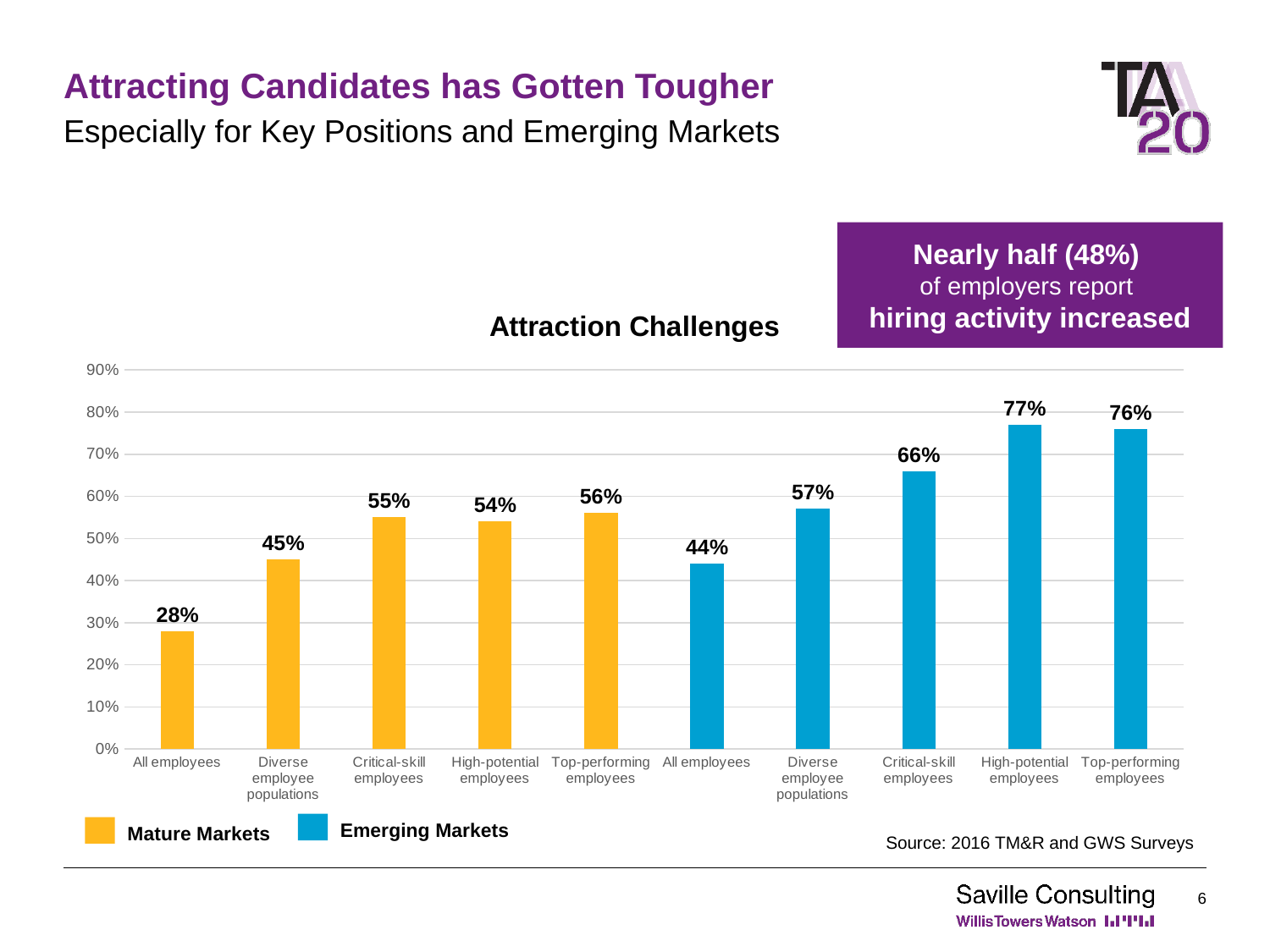
What kind of chart is shown? Bar chart What is the difference between Top-performing employees in Emerging Markets and in Mature Markets? 20% What is the difference between the Emerging Markets and Mature Markets values for All employees? 16% Which is larger: Diverse employee populations in Mature Markets or in Emerging Markets? Emerging Markets What is the title of the chart? Attraction Challenges What is the value for Critical-skill employees in Emerging Markets? 66% How many series does the legend list? 2 Which bar has the highest value on the chart? High-potential employees (Emerging Markets) What is the value for All employees in Mature Markets? 28% How many bars are plotted on the chart? 10 What is the value for High-potential employees in Emerging Markets? 77% Which bar has the lowest value on the chart? All employees (Mature Markets)